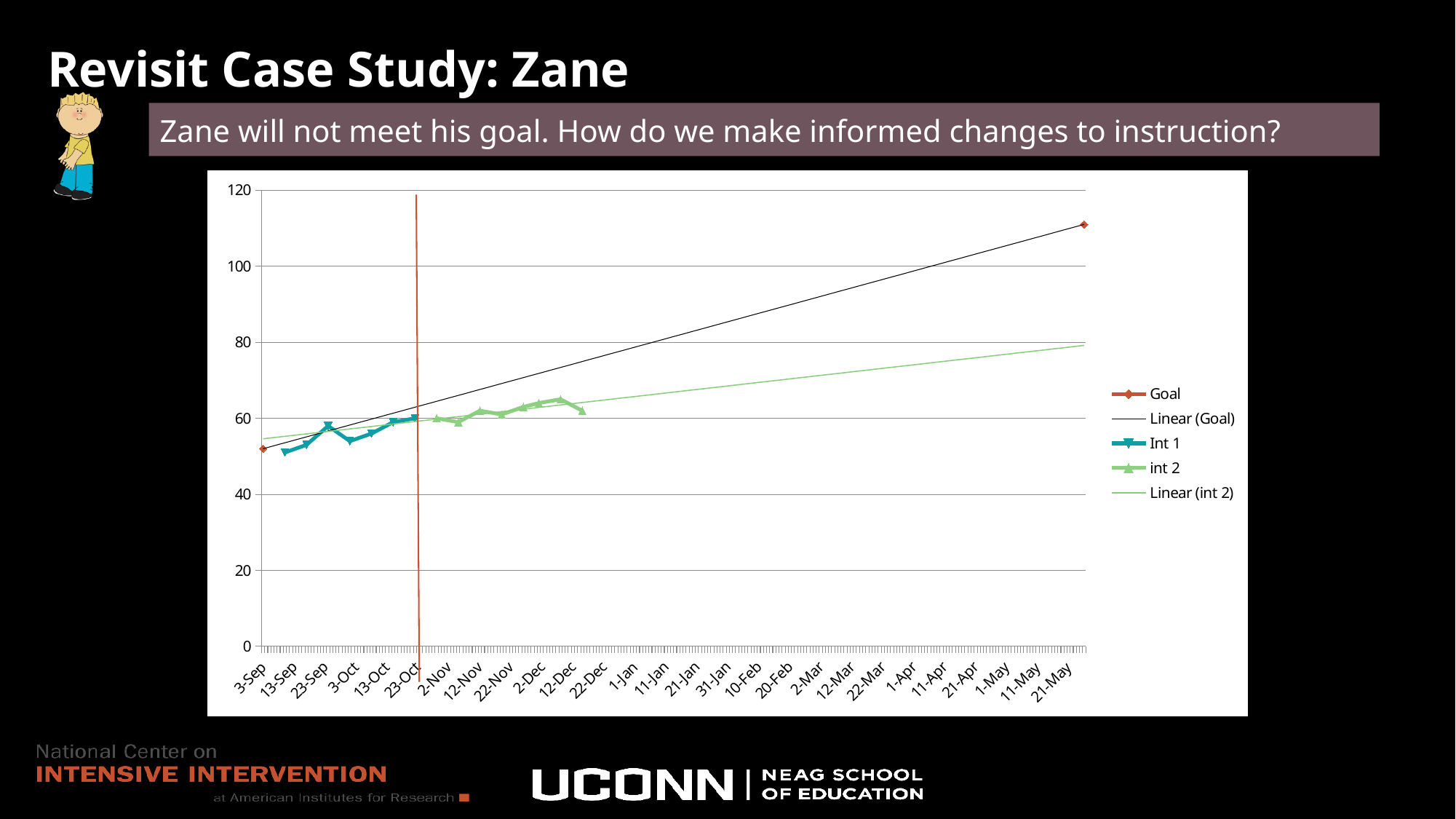
Is the Goal value at 21-May greater or less than 100? greater Does the Linear (Goal) line rise or fall from 3-Sep to 21-May? rise Is the Linear (Goal) line at 21-May greater or less than 100? greater How many series does the chart legend list? 5 Which series reaches the highest value on the chart? Goal What kind of chart is shown on the slide? line chart Does the Linear (int 2) line rise or fall across the x axis? rise At 21-May, which is higher: the Linear (Goal) line or the Linear (int 2) line? Linear (Goal) What is the highest value shown on the vertical axis? 120 Which series are listed in the chart legend? Goal, Linear (Goal), Int 1, int 2, Linear (int 2) Is the highest int 2 value greater or less than 80? less